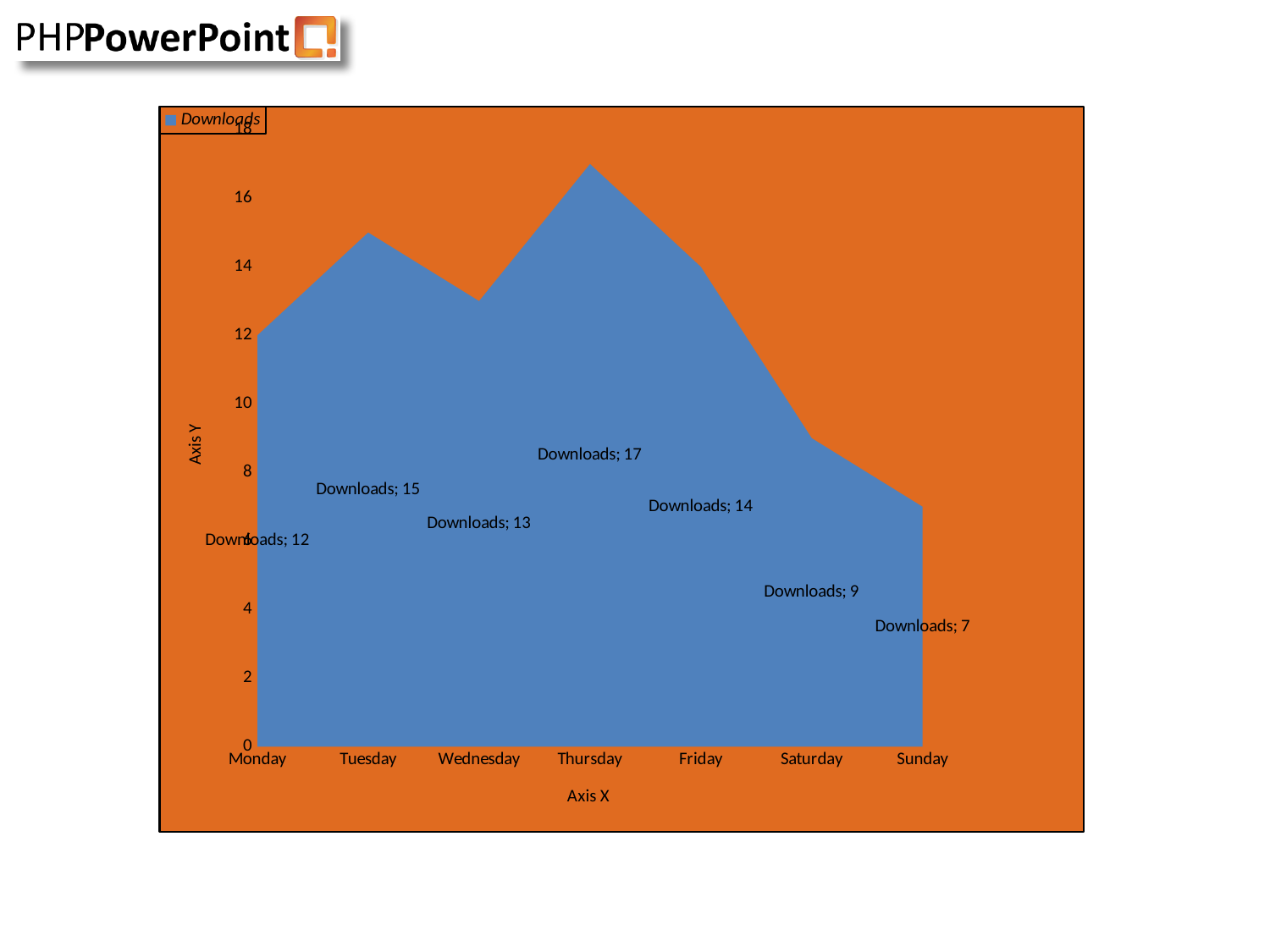
What is the Downloads value for Sunday? 7 Which has a larger Downloads value, Tuesday or Friday? Tuesday What is the difference between the Downloads values for Thursday and Sunday? 10 How many days are shown on the x axis? 7 What is the Downloads value for Tuesday? 15 Is the Downloads value for Saturday greater or less than 10? less What is the Downloads value for Thursday? 17 What is the title of the vertical axis? Axis Y How many series does the legend list? 1 What kind of chart is shown on the slide? area chart Which day has the highest Downloads value? Thursday Which day has the lowest Downloads value? Sunday